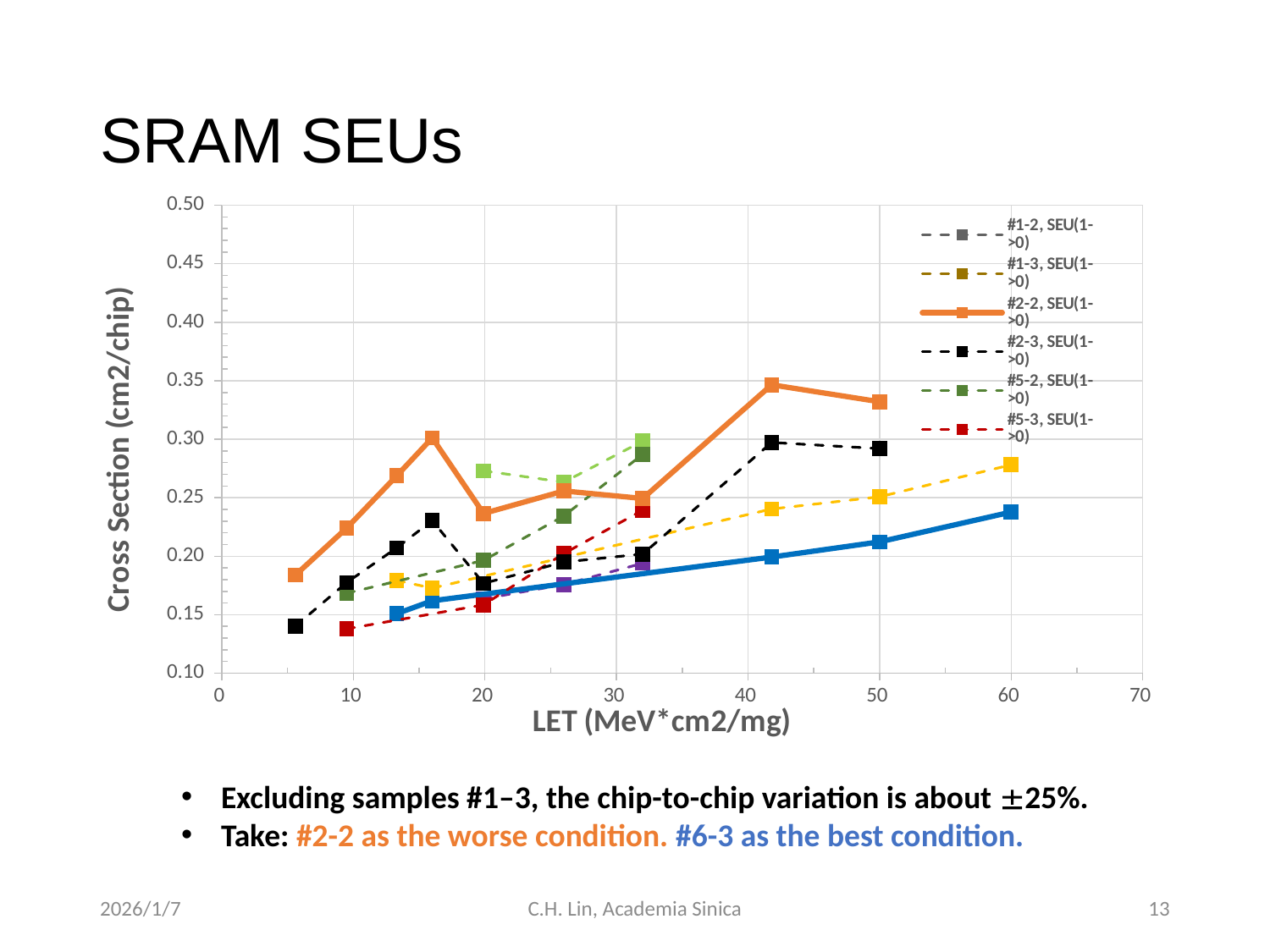
At LET 42, which series has the larger cross section, #2-2, SEU(1->0) or #2-3, SEU(1->0)? #2-2, SEU(1->0) How many data points are plotted for the #2-2, SEU(1->0) series? 9 Is the cross section for #2-3, SEU(1->0) at its lowest LET point (around 6) greater or less than 0.15? less What is the title of the y axis? Cross Section (cm2/chip) How many series does the legend list? 6 Does the cross section for #2-2, SEU(1->0) generally rise or fall as LET increases from about 6 to 50? rise What kind of chart is shown on the slide? line chart What is the title of the x axis? LET (MeV*cm2/mg) At LET 16, which series has the larger cross section, #2-2, SEU(1->0) or #2-3, SEU(1->0)? #2-2, SEU(1->0) Is the cross section for #2-2, SEU(1->0) at its lowest LET point (around 6) greater or less than 0.20? less Which series reaches the highest cross section on the chart? #2-2, SEU(1->0) Is the cross section for #2-2, SEU(1->0) at LET 42 greater or less than 0.30? greater